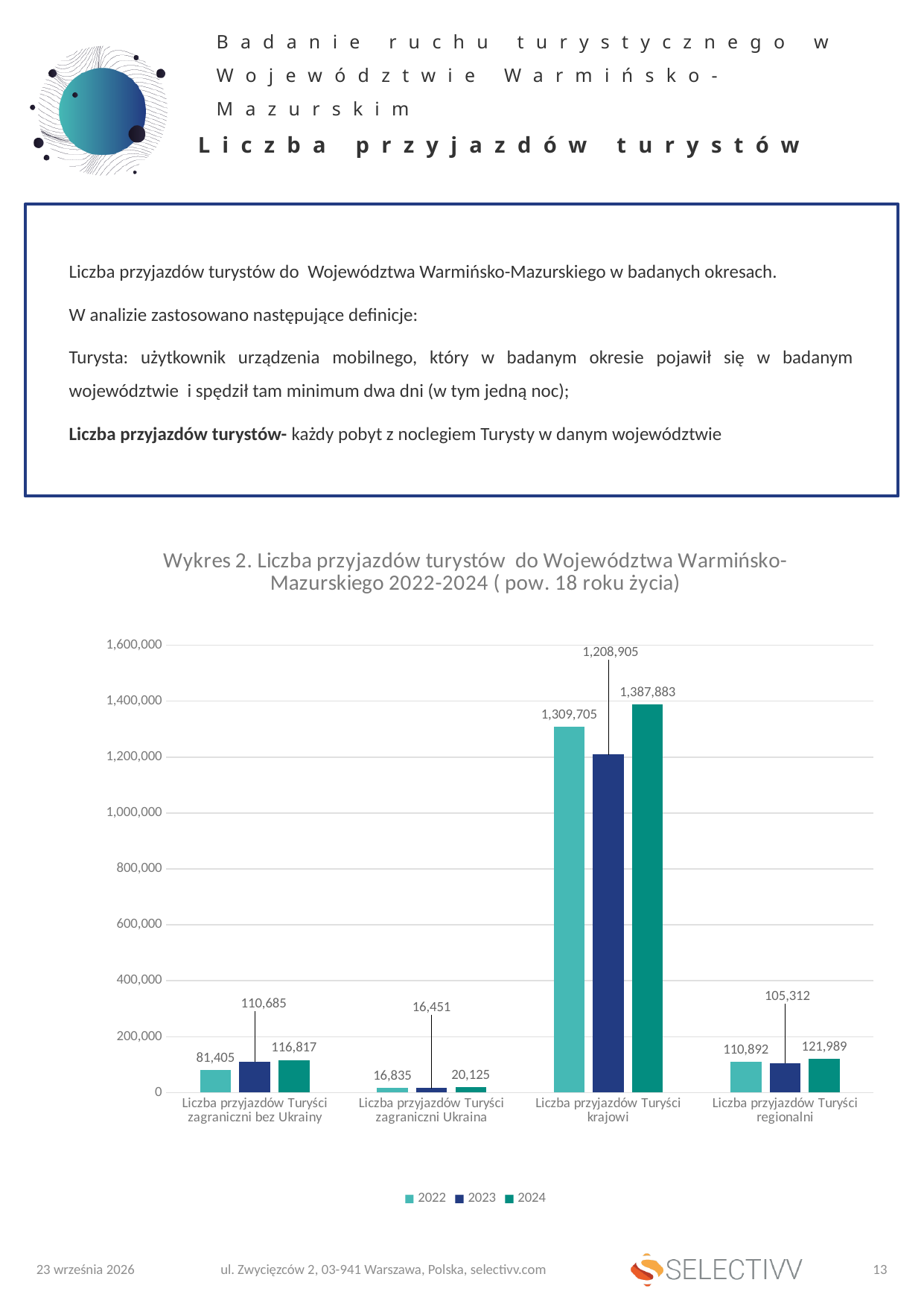
Which category has the lowest value in 2024? Liczba przyjazdów Turyści zagraniczni Ukraina What kind of chart is shown on the slide? Bar chart What is the difference between the 2024 and 2023 values for Turyści krajowi? 178,978 What is the value for Turyści krajowi in 2024? 1,387,883 Is the value for Turyści krajowi in 2022 greater or less than 1,200,000? greater What is the value for Turyści zagraniczni Ukraina in 2023? 16,451 How many categories are shown on the x axis? 4 Which category has the highest value in 2023? Liczba przyjazdów Turyści krajowi How many series does the legend list? 3 What is the value for Turyści regionalni in 2024? 121,989 Which is larger for Turyści regionalni: the 2022 value or the 2023 value? 2022 What is the value for Turyści zagraniczni bez Ukrainy in 2022? 81,405